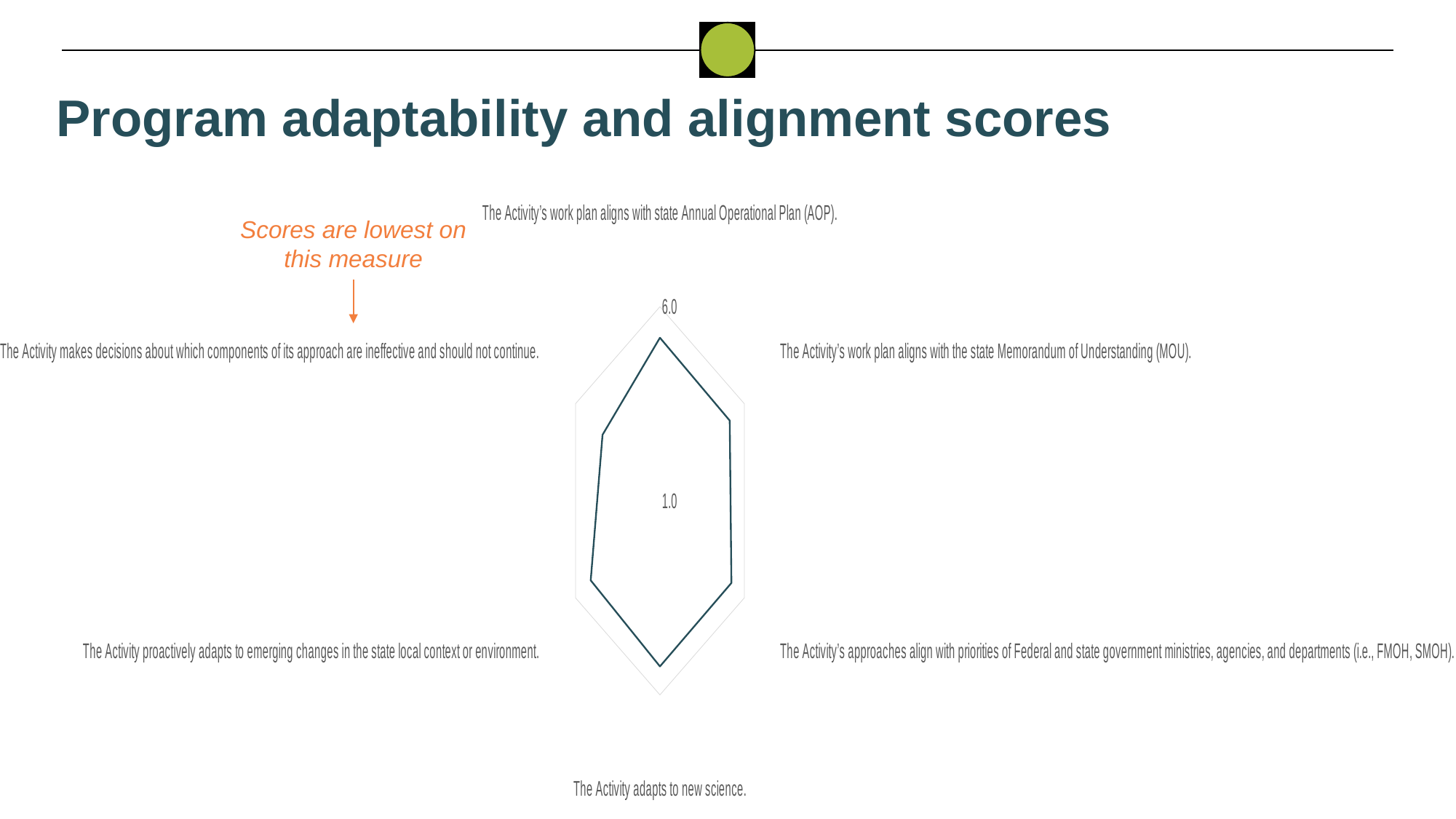
What kind of chart is shown on the slide? Radar chart Is the score for 'The Activity makes decisions about which components of its approach are ineffective and should not continue' greater or less than 6.0? less How many measures (axes) does the radar chart plot? 6 Which has the larger score: 'The Activity's work plan aligns with state Annual Operational Plan (AOP)' or 'The Activity makes decisions about which components of its approach are ineffective and should not continue'? The Activity's work plan aligns with state Annual Operational Plan (AOP). What does the orange annotation on the chart say? Scores are lowest on this measure What is the title of the slide containing the chart? Program adaptability and alignment scores On which measure is the score lowest? The Activity makes decisions about which components of its approach are ineffective and should not continue. What is the highest value labelled on the radar chart's scale? 6.0 Is the score for 'The Activity proactively adapts to emerging changes in the state local context or environment' greater or less than 1.0? greater Which has the larger score: 'The Activity adapts to new science' or 'The Activity makes decisions about which components of its approach are ineffective and should not continue'? The Activity adapts to new science.